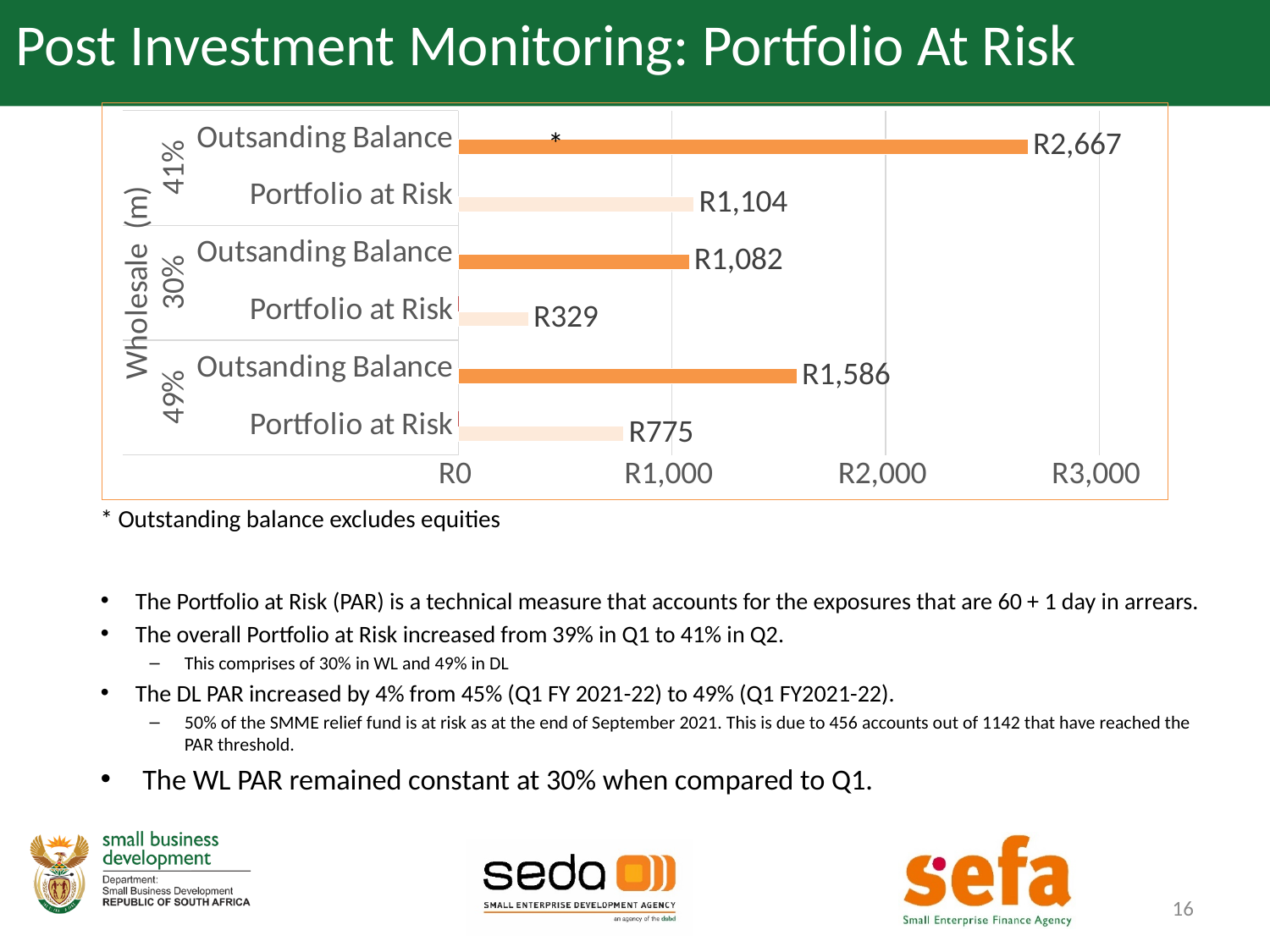
What is the Portfolio at Risk value in the 30% group? R329 Which bar has the highest value on the chart? Outstanding Balance in the 41% group Which bar has the lowest value on the chart? Portfolio at Risk in the 30% group What is the difference between the Outstanding Balance and the Portfolio at Risk in the 49% group? R811 Which is larger: the Portfolio at Risk in the 41% group or the Outstanding Balance in the 30% group? Portfolio at Risk in the 41% group What is the Outstanding Balance value in the 41% group? R2,667 How many bars are plotted on the chart? 6 What is the difference between the Outstanding Balance and the Portfolio at Risk in the 30% group? R753 What is the Outstanding Balance value in the 49% group? R1,586 What type of chart is shown on the slide? Bar chart Is the Outstanding Balance in the 49% group greater or less than R2,000? less What is the Portfolio at Risk value in the 49% group? R775